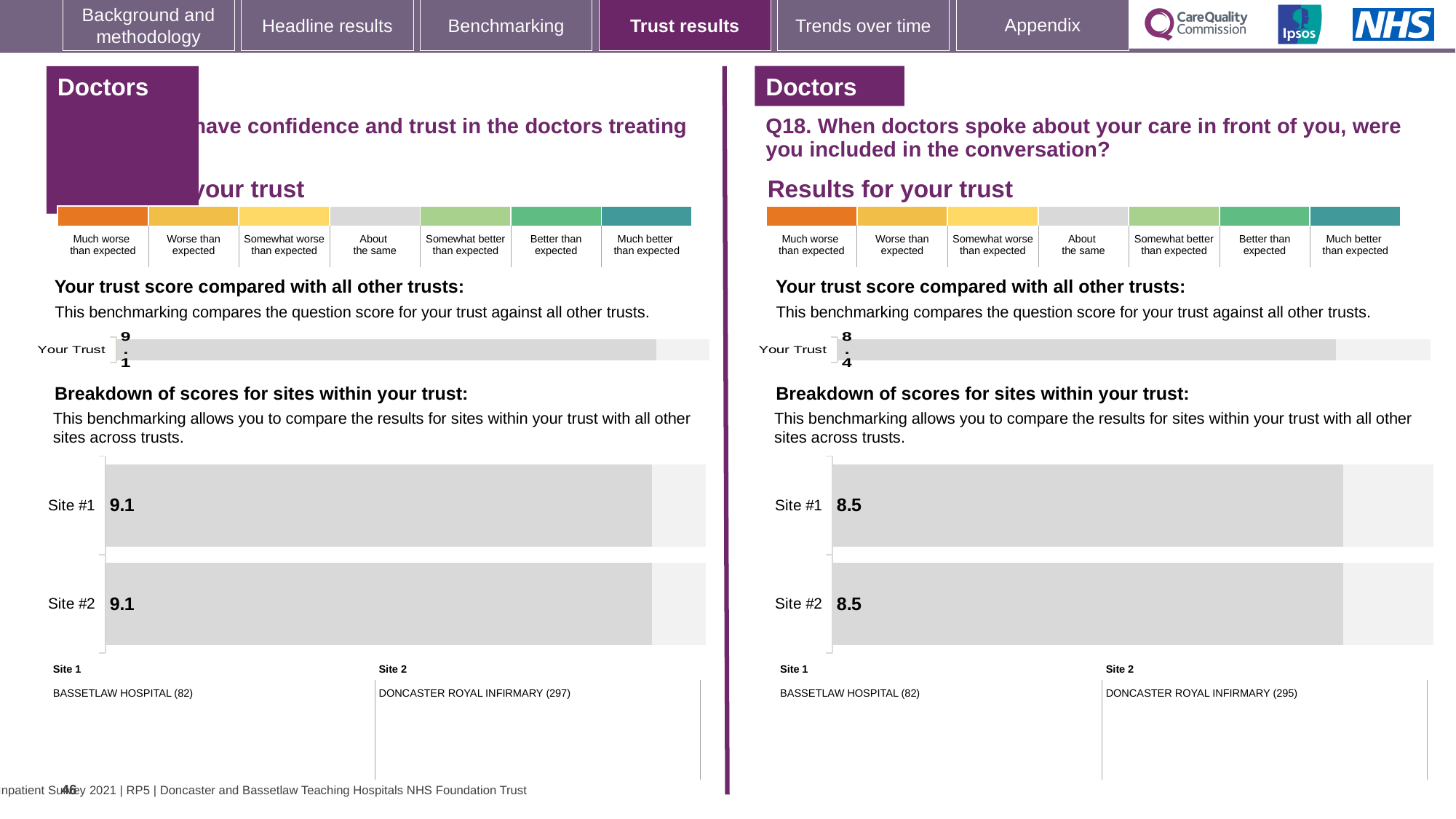
On the left-hand 'Breakdown of scores for sites within your trust' chart, what is the value for Site #1? 9.1 On the right-hand (Q18) 'Breakdown of scores for sites within your trust' chart, what is the value for Site #2? 8.5 On the right-hand (Q18) 'Breakdown of scores for sites within your trust' chart, what is the value for Site #1? 8.5 On the right-hand (Q18) site breakdown chart, which hospital is Site 2? DONCASTER ROYAL INFIRMARY (295) On the right-hand (Q18) 'Your trust score compared with all other trusts' chart, what is the value for Your Trust? 8.4 On the left-hand 'Breakdown of scores for sites within your trust' chart, what is the value for Site #2? 9.1 What kind of chart is the right-hand (Q18) 'Breakdown of scores for sites within your trust' chart? Bar chart How many sites are shown on the right-hand (Q18) 'Breakdown of scores for sites within your trust' chart? 2 Which is larger: the Your Trust value on the left-hand chart or the Your Trust value on the right-hand (Q18) chart? Left-hand chart (9.1) On the left-hand 'Your trust score compared with all other trusts' chart, what is the value for Your Trust? 9.1 On the right-hand (Q18) 'Breakdown of scores for sites within your trust' chart, what is the difference between the Site #1 and Site #2 values? 0 How many sites are shown on the left-hand 'Breakdown of scores for sites within your trust' chart? 2